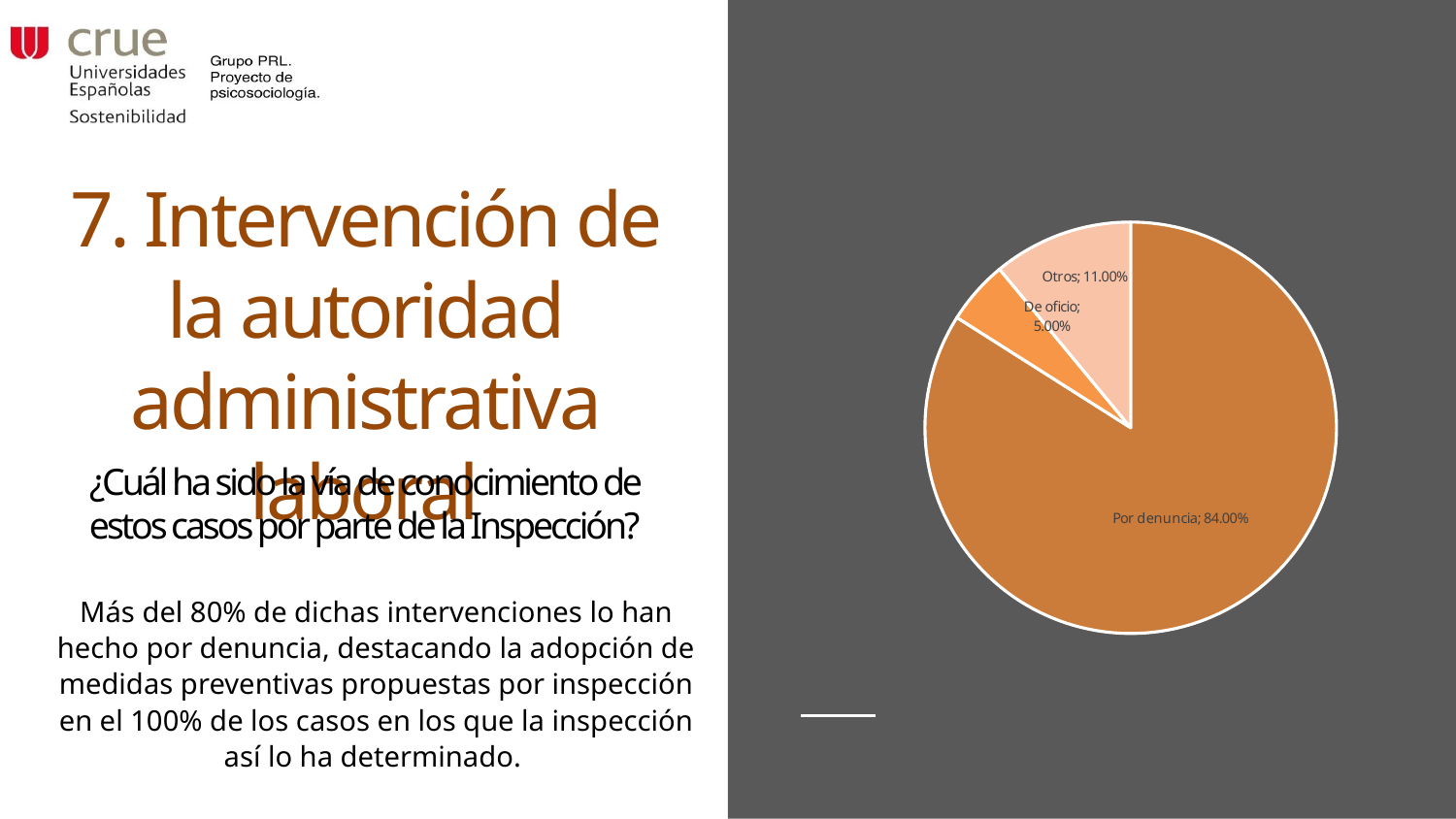
What is the value for "Otros" in the pie chart? 11.00% What is the difference between the "Otros" and "De oficio" values in the pie chart? 6.00% What is the combined share of "De oficio" and "Otros" in the pie chart? 16.00% What is the value for "Por denuncia" in the pie chart? 84.00% Which category has the largest slice in the pie chart? Por denuncia Which category has the smallest slice in the pie chart? De oficio What share of the pie does "Por denuncia" represent? 84.00% What is the difference between the "Por denuncia" and "Otros" values in the pie chart? 73.00% How many slices does the pie chart have? 3 What is the value for "De oficio" in the pie chart? 5.00% What kind of chart is shown on the slide? Pie chart Which is larger in the pie chart, "Otros" or "De oficio"? Otros